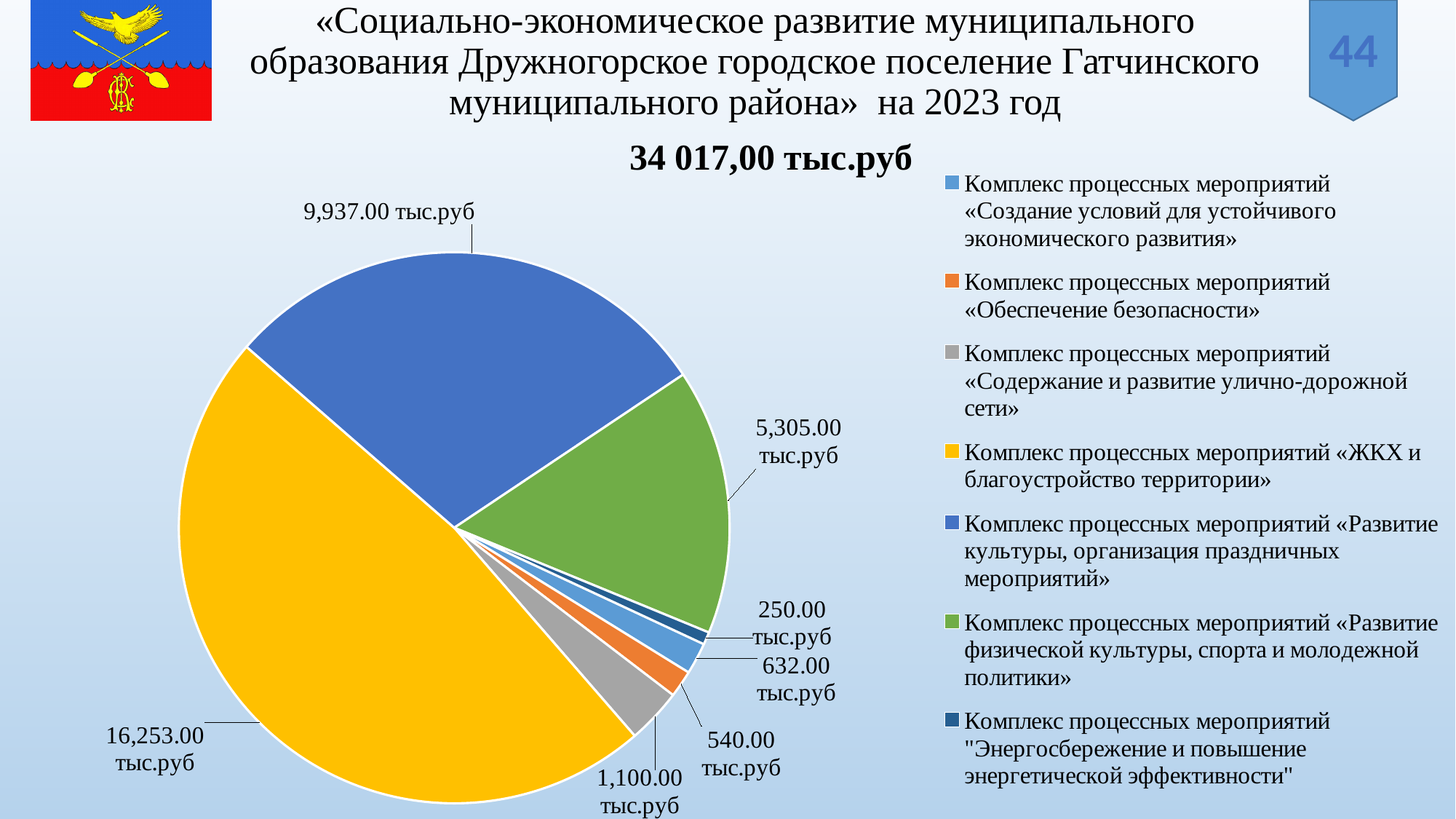
What type of chart is shown on the slide? Pie chart Which category has the largest slice of the pie? «ЖКХ и благоустройство территории» What is the value for «ЖКХ и благоустройство территории» (yellow slice)? 16,253.00 тыс.руб How many entries does the legend list? 7 Which category has the smallest slice of the pie? «Энергосбережение и повышение энергетической эффективности» What total amount is shown above the pie chart? 34 017,00 тыс.руб How many slices does the pie chart have? 7 What is the difference between the values for «ЖКХ и благоустройство территории» and «Развитие культуры, организация праздничных мероприятий»? 6,316.00 тыс.руб Which is larger: the value for «Обеспечение безопасности» or for «Содержание и развитие улично-дорожной сети»? «Содержание и развитие улично-дорожной сети» What is the value for «Энергосбережение и повышение энергетической эффективности» (dark blue slice)? 250.00 тыс.руб What is the value for «Развитие культуры, организация праздничных мероприятий» (blue slice)? 9,937.00 тыс.руб What is the value for «Развитие физической культуры, спорта и молодежной политики» (green slice)? 5,305.00 тыс.руб